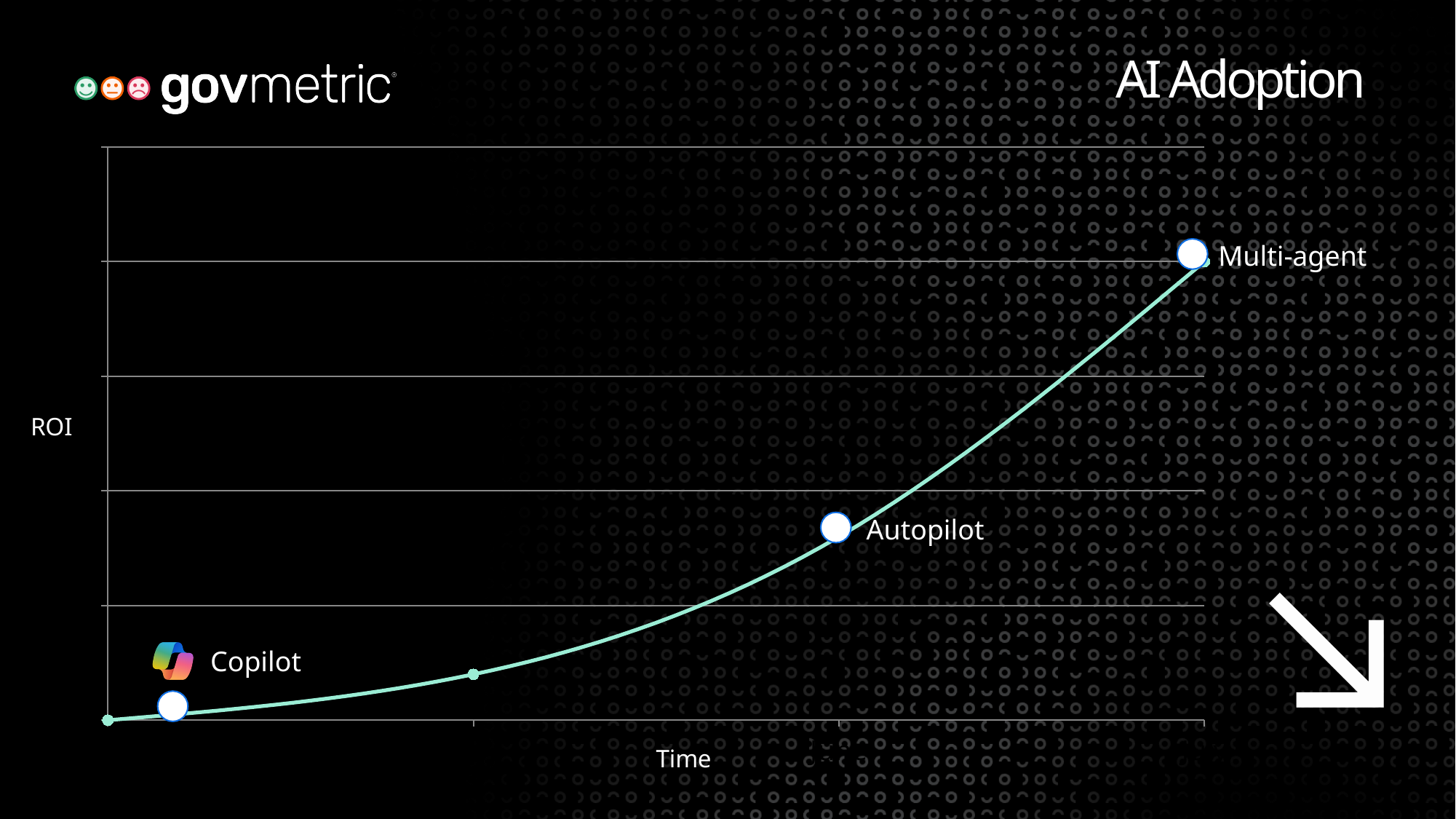
What is the label on the vertical axis of the chart? ROI Which labelled point appears furthest to the right along the Time axis? Multi-agent What kind of chart is shown on the slide? line chart Which has the higher ROI on the chart, Autopilot or Copilot? Autopilot What is the title of the slide containing the chart? AI Adoption Does ROI rise or fall as Time increases along the x axis? rise Which labelled point on the chart has the highest ROI? Multi-agent Which has the higher ROI on the chart, Autopilot or Multi-agent? Multi-agent How many labelled points are marked on the line? 3 Which labelled point on the chart has the lowest ROI? Copilot